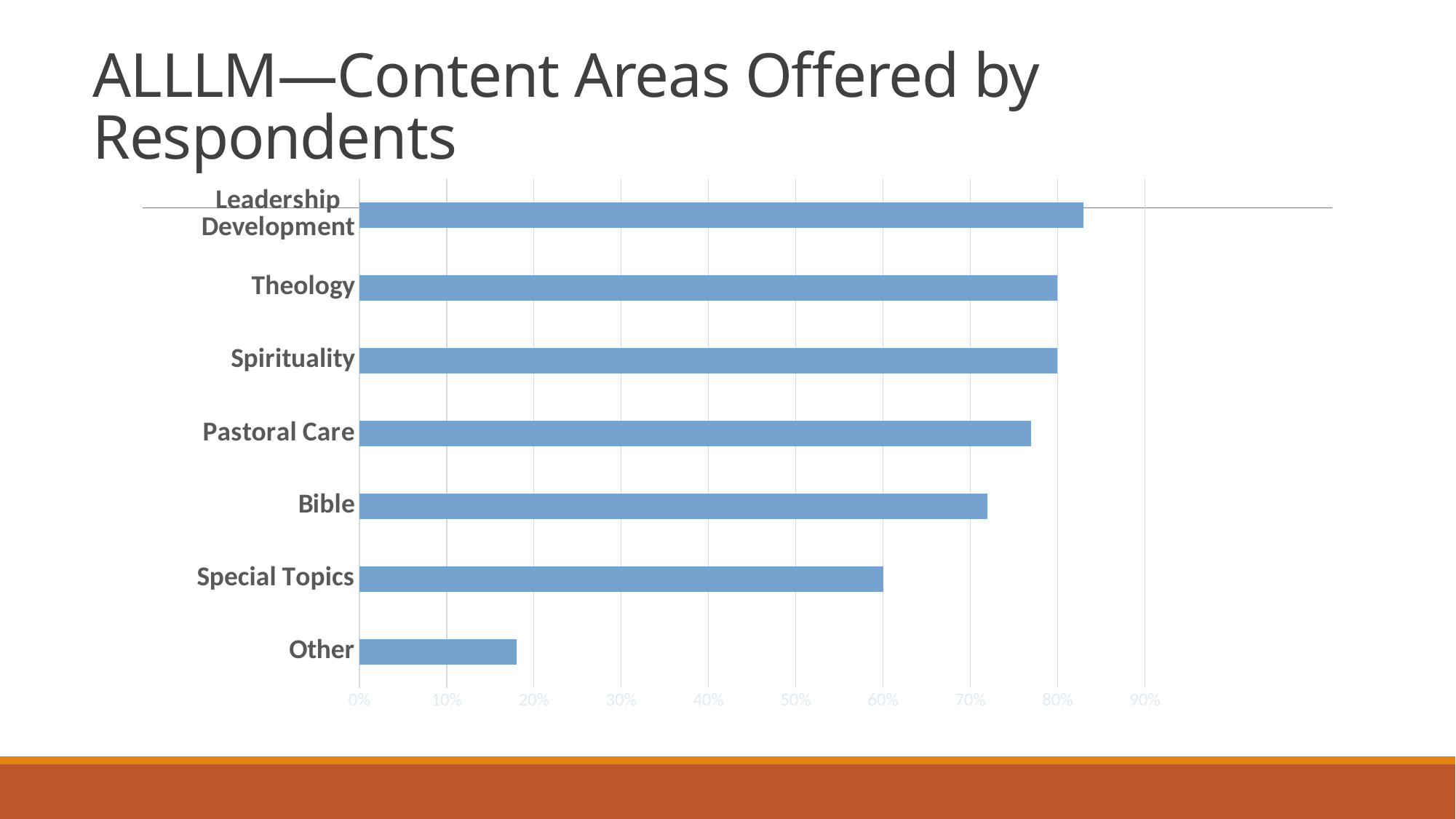
Is the value for Other greater or less than 20%? less Which content area has the lowest percentage? Other How many content areas are shown in the chart? 7 Which is larger, the value for Special Topics or the value for Other? Special Topics Is the value for Pastoral Care greater or less than 80%? less What is the value for Special Topics? 60% Which is larger, the value for Pastoral Care or the value for Bible? Pastoral Care Is the value for Leadership Development greater or less than 80%? greater Which content area has the highest percentage? Leadership Development What type of chart is shown on the slide? bar chart What is the title of the slide containing the chart? ALLLM—Content Areas Offered by Respondents